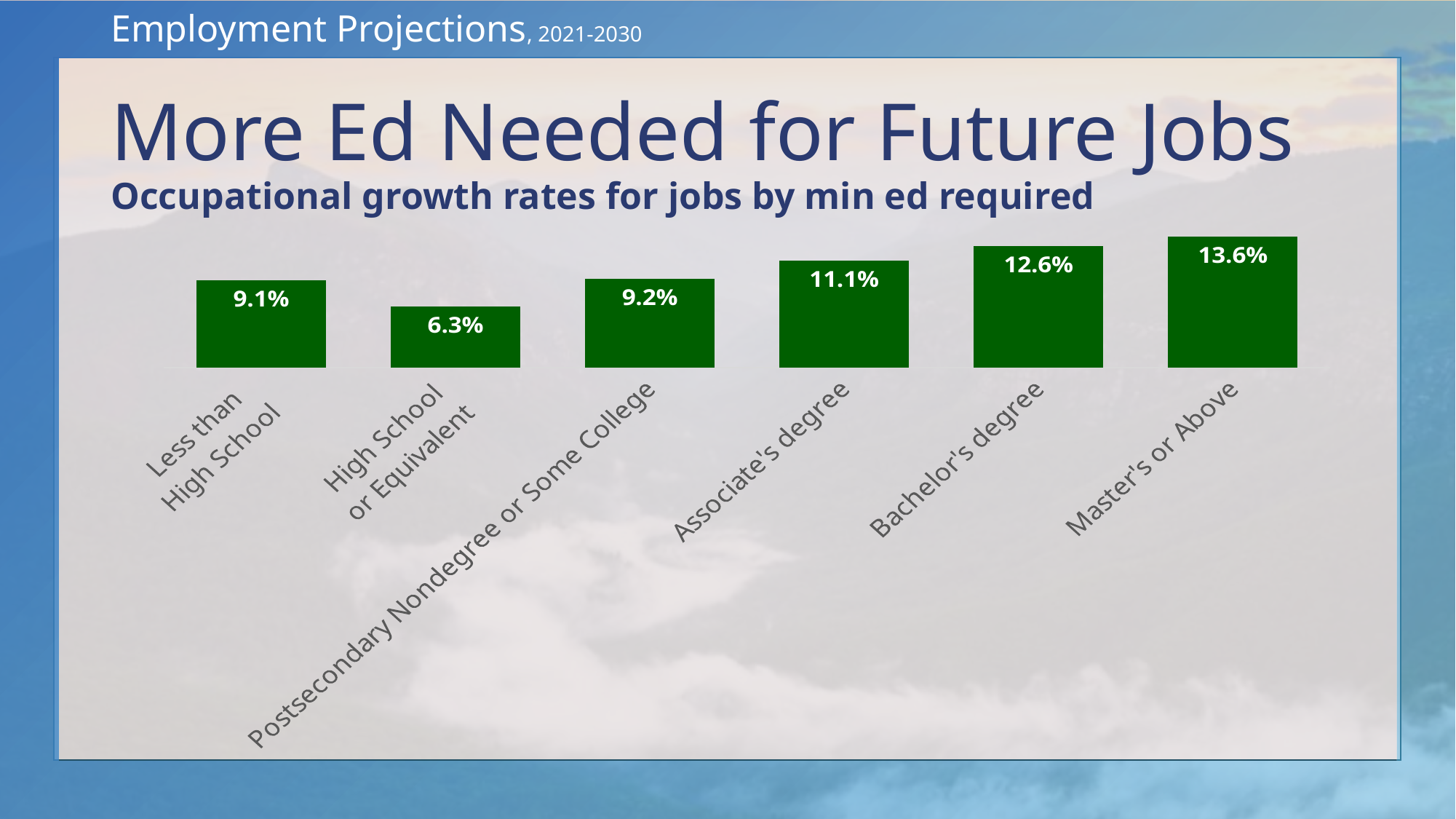
How many education categories are shown in the chart? 6 What is the difference between the growth rates for Associate's degree and High School or Equivalent? 4.8% What is the occupational growth rate for jobs requiring a Bachelor's degree? 12.6% What is the difference between the growth rates for Master's or Above and Less than High School? 4.5% What is the growth rate for jobs requiring High School or Equivalent? 6.3% Which education level has the lowest occupational growth rate? High School or Equivalent Which has a higher growth rate, Associate's degree or Bachelor's degree? Bachelor's degree Which education level has the highest occupational growth rate? Master's or Above Which has a higher growth rate, Less than High School or High School or Equivalent? Less than High School What is the subtitle describing the chart's data? Occupational growth rates for jobs by min ed required What kind of chart is shown on the slide? Bar chart What is the growth rate for jobs requiring Postsecondary Nondegree or Some College? 9.2%